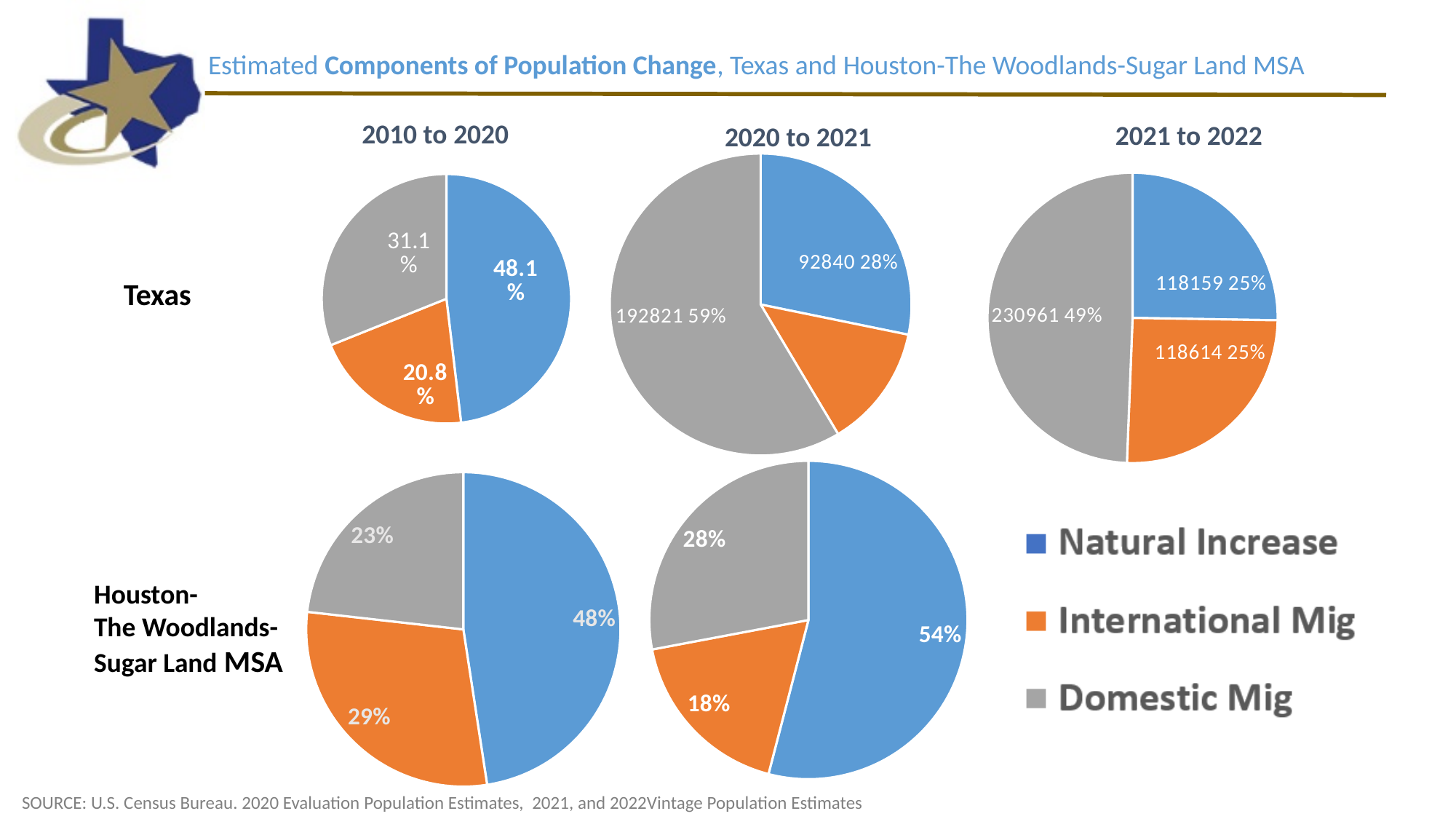
In the Texas 2021 to 2022 pie chart, what value is shown for International Mig? 118614 What kind of chart is used on this slide? Pie chart In the Texas 2020 to 2021 pie chart, what share is Natural Increase? 28% In the Texas 2021 to 2022 pie chart, which is larger, the Domestic Mig value or the Natural Increase value? Domestic Mig In the Texas 2021 to 2022 pie chart, which component has the largest slice? Domestic Mig In the Texas 2010 to 2020 pie chart, what share is Natural Increase? 48.1% In the Texas 2010 to 2020 pie chart, what share is International Mig? 20.8% How many components does the legend list? 3 In the Houston-The Woodlands-Sugar Land MSA 2020 to 2021 pie chart, what is the difference in percentage points between Natural Increase and Domestic Mig? 26 In the Houston-The Woodlands-Sugar Land MSA 2010 to 2020 pie chart, what share is Domestic Mig? 23% In the Houston-The Woodlands-Sugar Land MSA 2020 to 2021 pie chart, which component has the smallest slice? International Mig In the Texas 2020 to 2021 pie chart, what value is shown for Domestic Mig? 192821